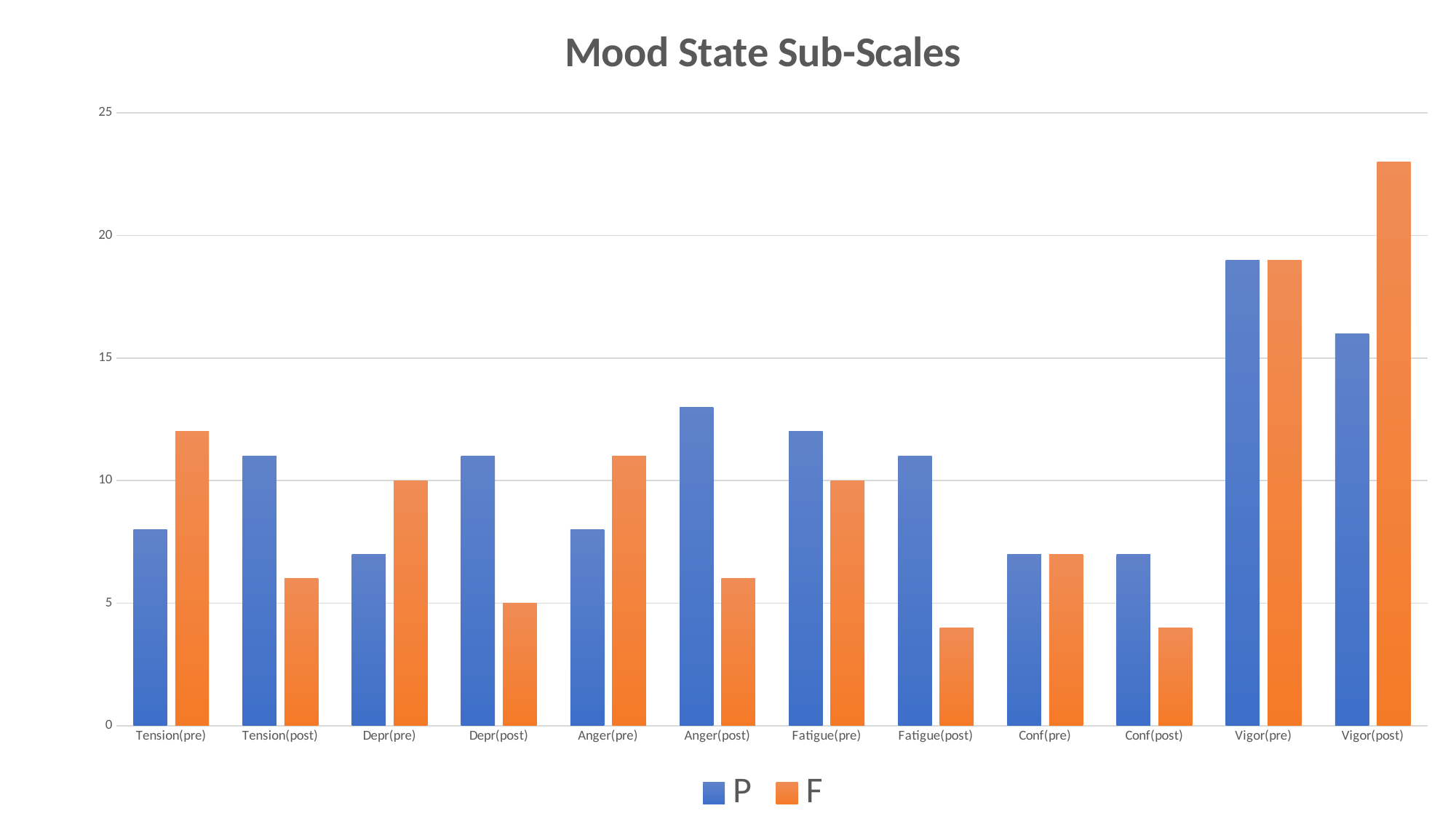
How many categories are shown on the x axis? 12 Which category has the highest F value? Vigor(post) What is the title of the chart? Mood State Sub-Scales What kind of chart is shown on the slide? bar chart For Anger(post), which series has the larger value, P or F? P What is the value of the F series for Depr(post)? 5 What is the value of the F series for Depr(pre)? 10 Is the F value for Vigor(post) greater or less than 20? greater Is the P value for Tension(pre) greater or less than 10? less How many series does the legend list? 2 What is the value of the F series for Fatigue(pre)? 10 Which category has the highest P value? Vigor(pre)